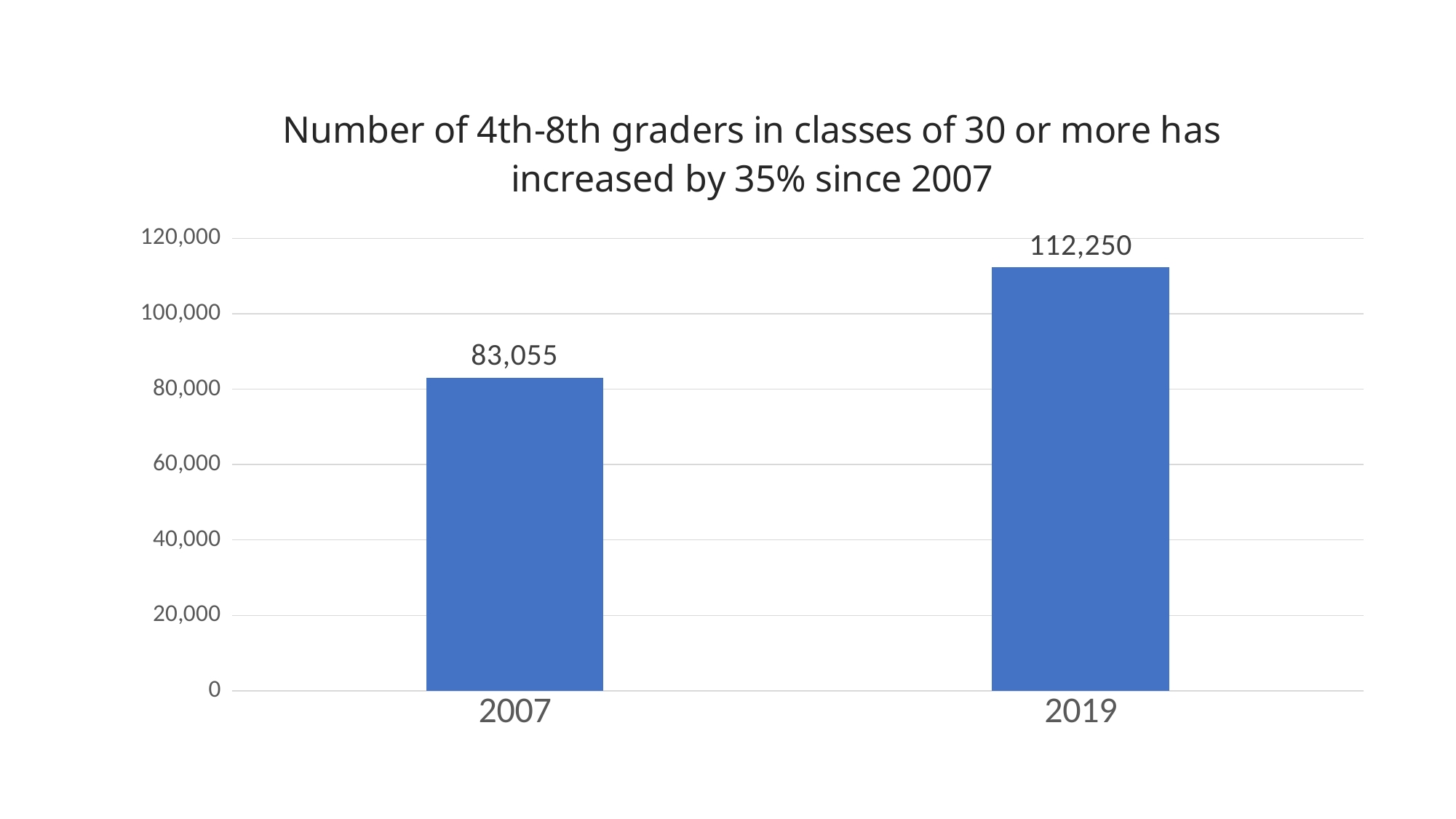
What is the difference between the values for 2019 and 2007? 29,195 Do the values rise or fall from 2007 to 2019? Rise Which year has the lower value? 2007 What is the value for 2019? 112,250 What is the value for 2007? 83,055 Is the value for 2019 larger than the value for 2007? Yes How many bars are shown in the chart? 2 What kind of chart is shown on the slide? Bar chart What is the title of the chart? Number of 4th-8th graders in classes of 30 or more has increased by 35% since 2007 Is the value for 2007 greater or less than 100,000? less Which year has the higher value? 2019 Is the value for 2019 greater or less than 100,000? greater